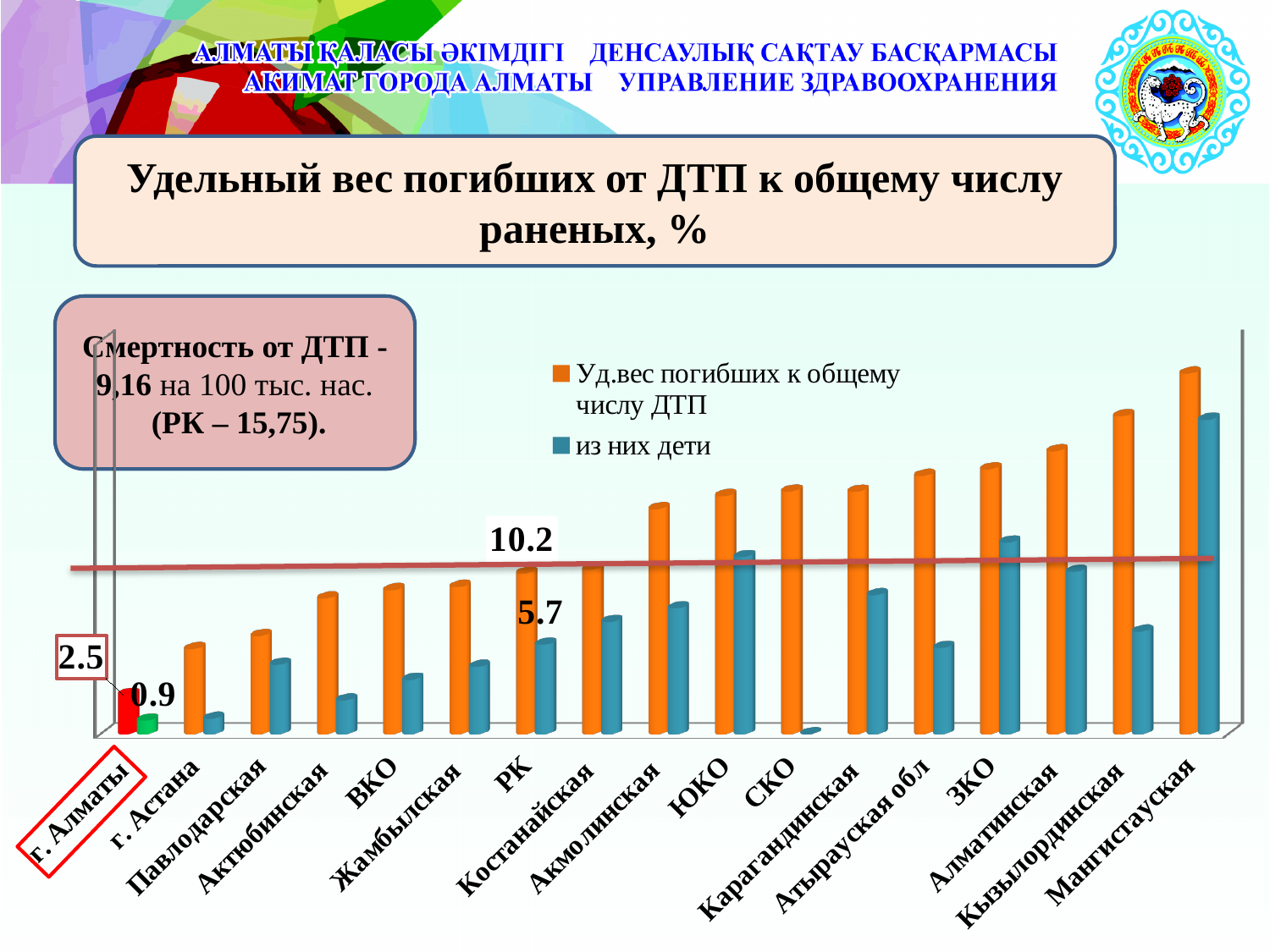
Which has a larger 'Уд.вес погибших к общему числу ДТП' value: Мангистауская or Кызылординская? Мангистауская What is the difference between the 'Уд.вес погибших к общему числу ДТП' values for РК and г. Алматы? 7.7 What type of chart is shown on the slide? Bar chart Which region has the highest value for 'Уд.вес погибших к общему числу ДТП'? Мангистауская Which category has the lowest value for 'Уд.вес погибших к общему числу ДТП'? г. Алматы What is the value of 'Уд.вес погибших к общему числу ДТП' for г. Алматы? 2.5 What is the value of 'из них дети' for РК? 5.7 How many series does the chart legend list? 2 What is the value of 'из них дети' for г. Алматы? 0.9 How many categories are shown on the x axis of the chart? 17 What is the value of 'Уд.вес погибших к общему числу ДТП' for РК? 10.2 What is the difference between the 'из них дети' values for РК and г. Алматы? 4.8